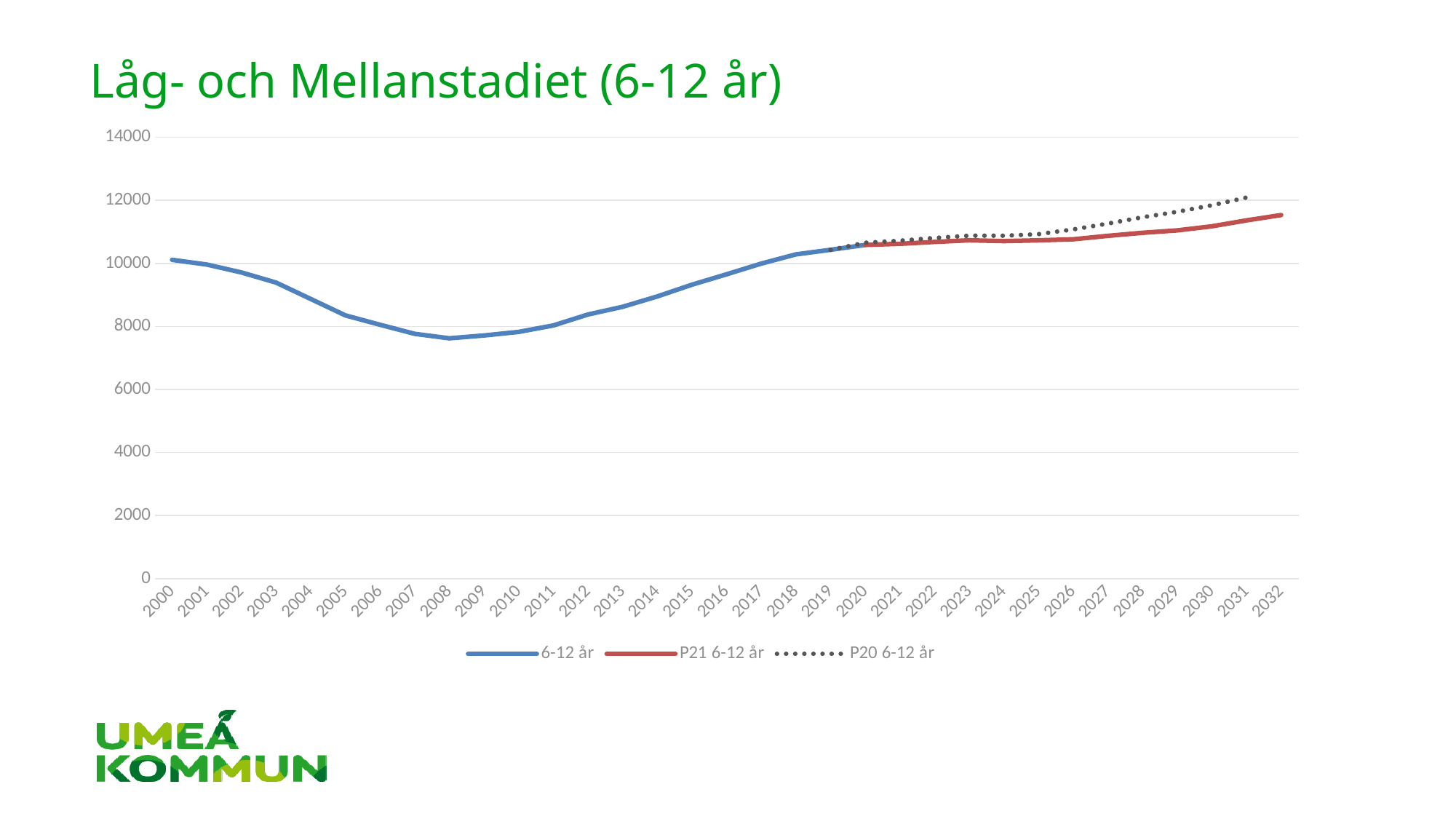
How many years are shown on the x axis? 33 What kind of chart is shown on the slide? Line chart Is the value of the 6-12 år series in 2008 greater or less than 8000? less In 2031, which series has the higher value, P20 6-12 år or P21 6-12 år? P20 6-12 år How many series does the legend list? 3 Is the value of the 6-12 år series in 2014 greater or less than 10000? less Is the value of the P21 6-12 år series in 2032 greater or less than 10000? greater In which year does the 6-12 år series reach its lowest value? 2008 Does the 6-12 år series rise or fall between 2000 and 2008? Fall What is the title of the chart? Låg- och Mellanstadiet (6-12 år) Does the 6-12 år series rise or fall between 2008 and 2019? Rise